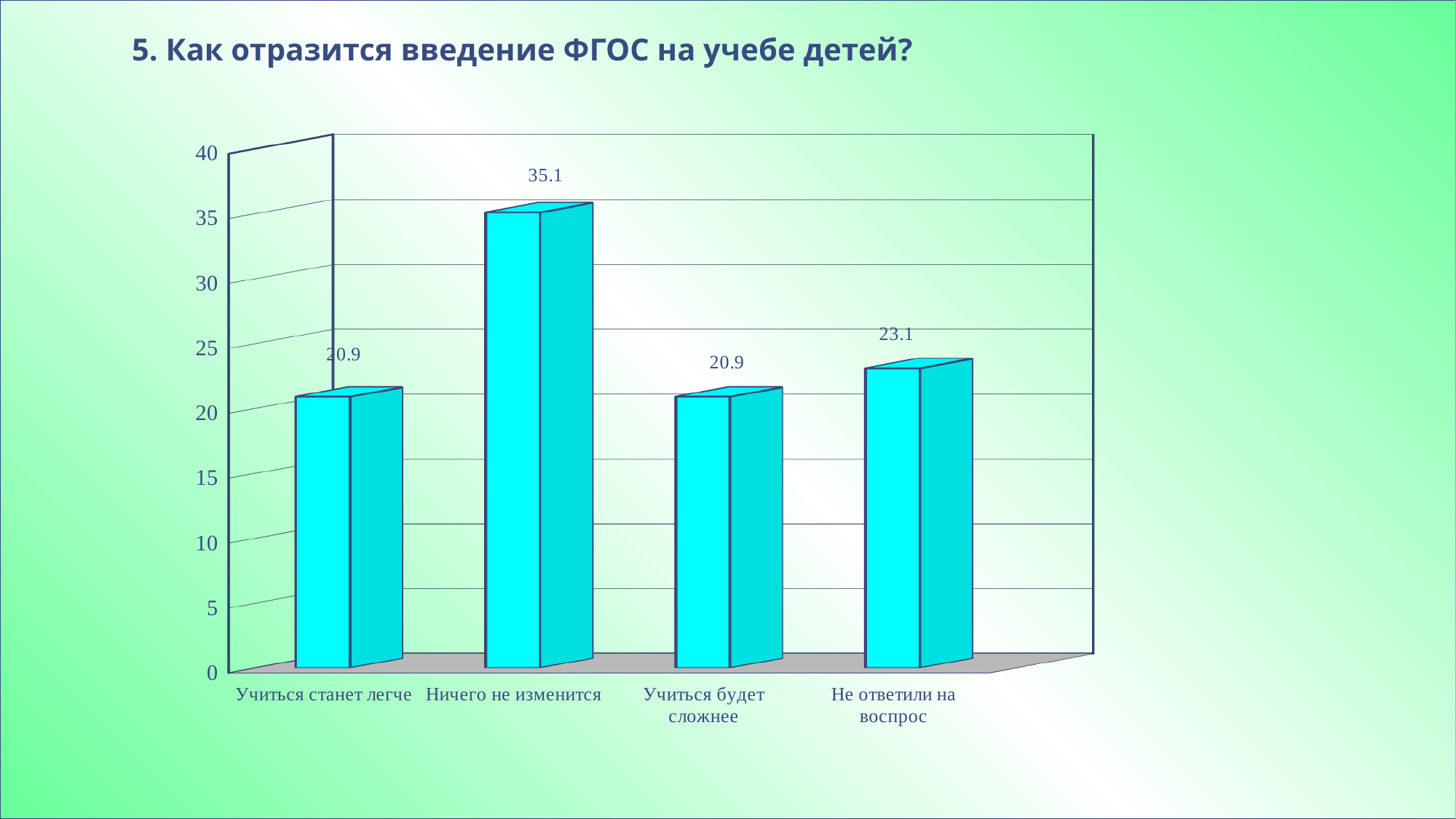
What kind of chart is shown on the slide? bar chart What is the value for "Учиться станет легче"? 20.9 What is the value for "Не ответили на воспрос"? 23.1 Which category has the highest value? Ничего не изменится How many categories are shown on the chart? 4 Is the value for "Ничего не изменится" greater or less than 30? greater What is the value for "Ничего не изменится"? 35.1 Is the value for "Учиться будет сложнее" greater or less than 25? less What is the difference between the values for "Не ответили на воспрос" and "Учиться будет сложнее"? 2.2 What is the title of the slide? 5. Как отразится введение ФГОС на учебе детей? Which is larger, the value for "Не ответили на воспрос" or the value for "Учиться станет легче"? Не ответили на воспрос What is the difference between the values for "Ничего не изменится" and "Не ответили на воспрос"? 12